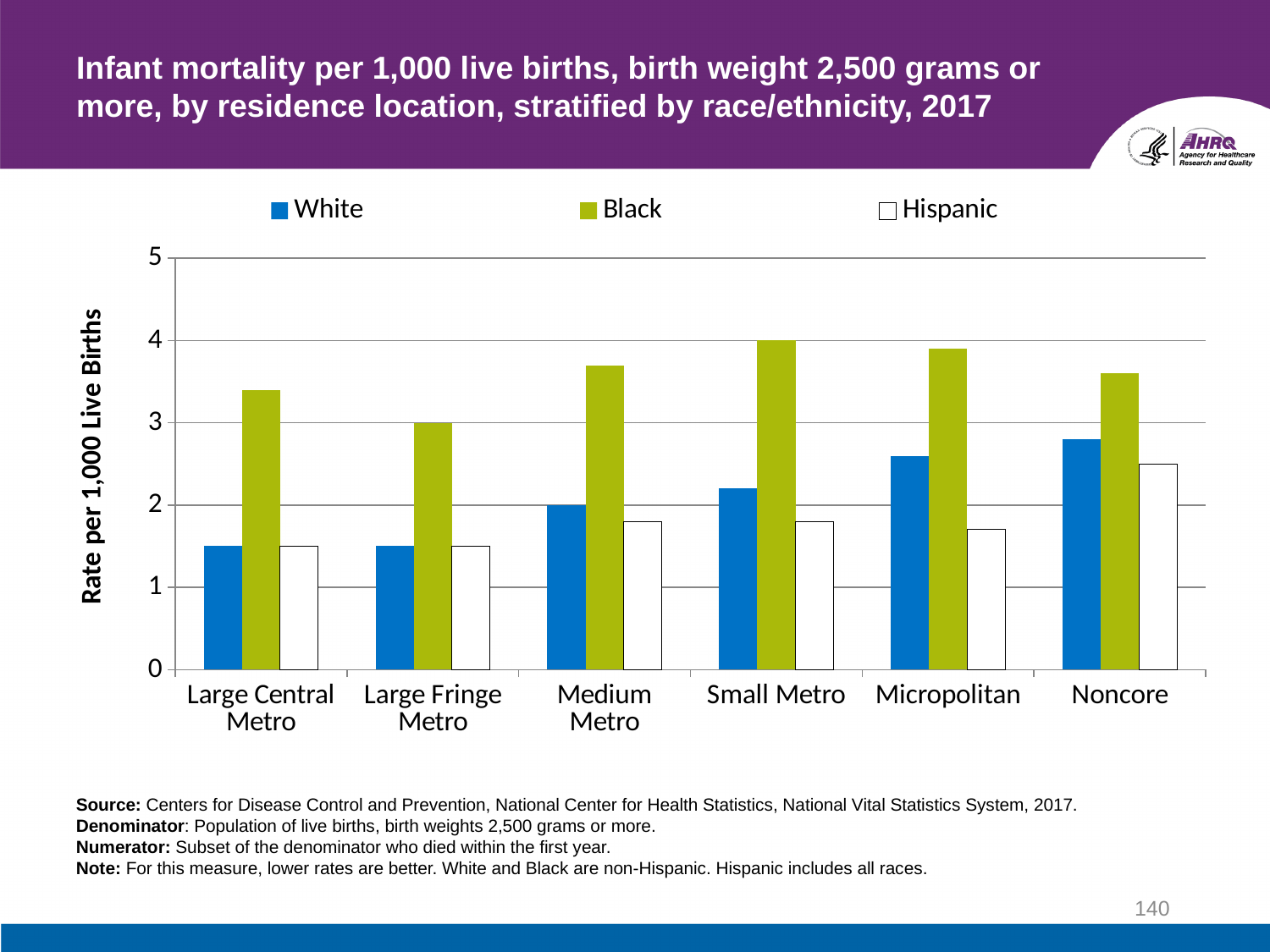
Is the value for Hispanic in Micropolitan greater or less than 2? less Which residence location has the lowest rate for Black? Large Fringe Metro How many series does the legend list? 3 What is the rate for Black in Small Metro? 4 How many residence location categories are shown on the x axis? 6 What is the rate for Black in Large Fringe Metro? 3 What is the label on the y axis? Rate per 1,000 Live Births Is the value for White in Noncore greater or less than 3? less What kind of chart is shown on the slide? bar chart Is the value for Black in Large Central Metro greater or less than 3? greater Which residence location has the highest rate for Hispanic? Noncore In Large Central Metro, which is larger, the rate for White or the rate for Black? Black